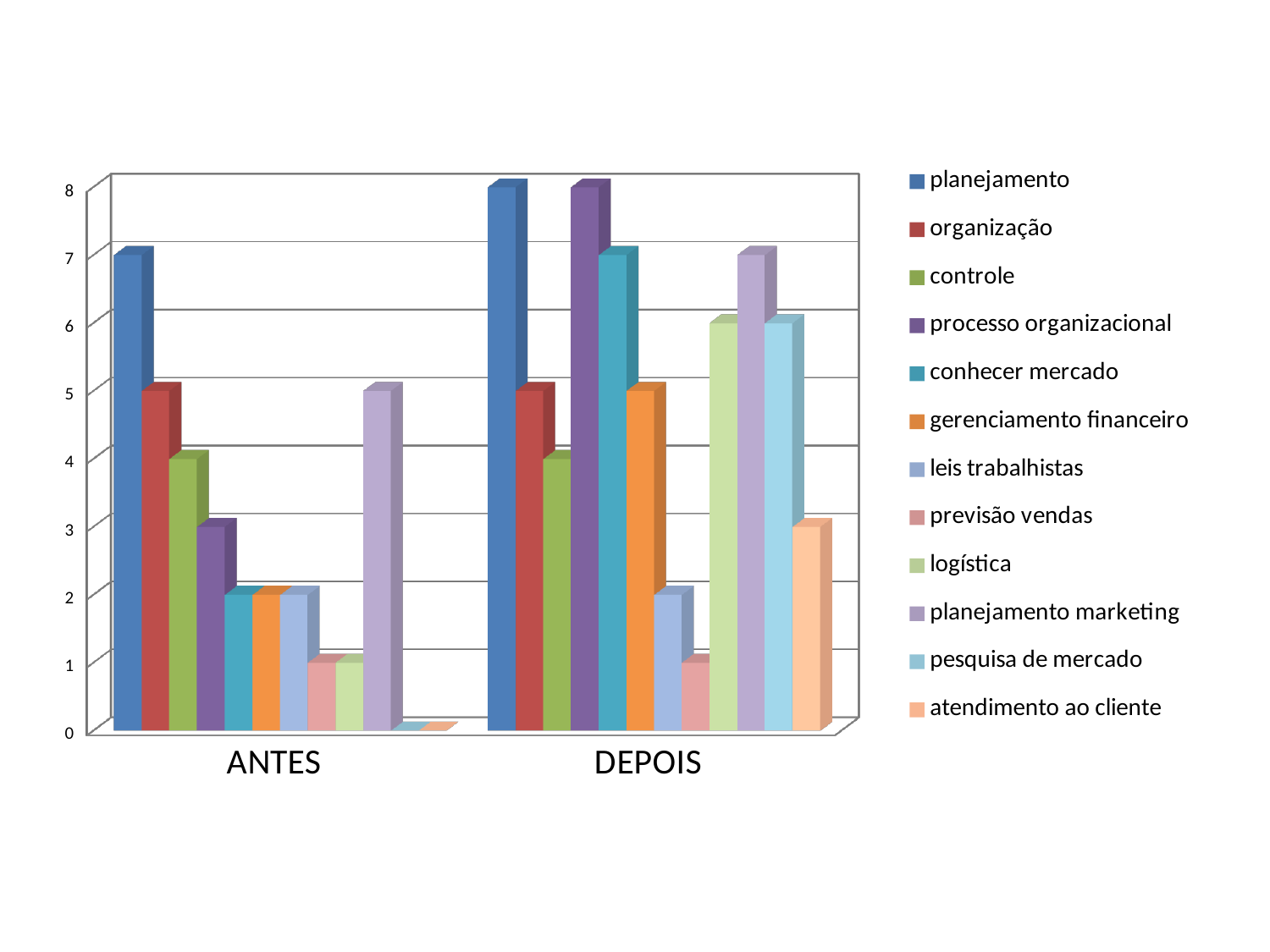
Is the value for processo organizacional in ANTES greater or less than 4? less Which series is shown in dark blue in the legend? planejamento Is the value for conhecer mercado in DEPOIS greater or less than 6? greater What are the two categories on the x axis? ANTES and DEPOIS Which is larger, the value for atendimento ao cliente in ANTES or in DEPOIS? DEPOIS Is the value for planejamento in ANTES greater or less than 6? greater Which is larger, the value for logística in ANTES or in DEPOIS? DEPOIS What kind of chart is shown on the slide? bar chart How many categories are shown on the x axis? 2 How many series does the legend list? 12 Which series has the lowest value in the ANTES category? pesquisa de mercado and atendimento ao cliente